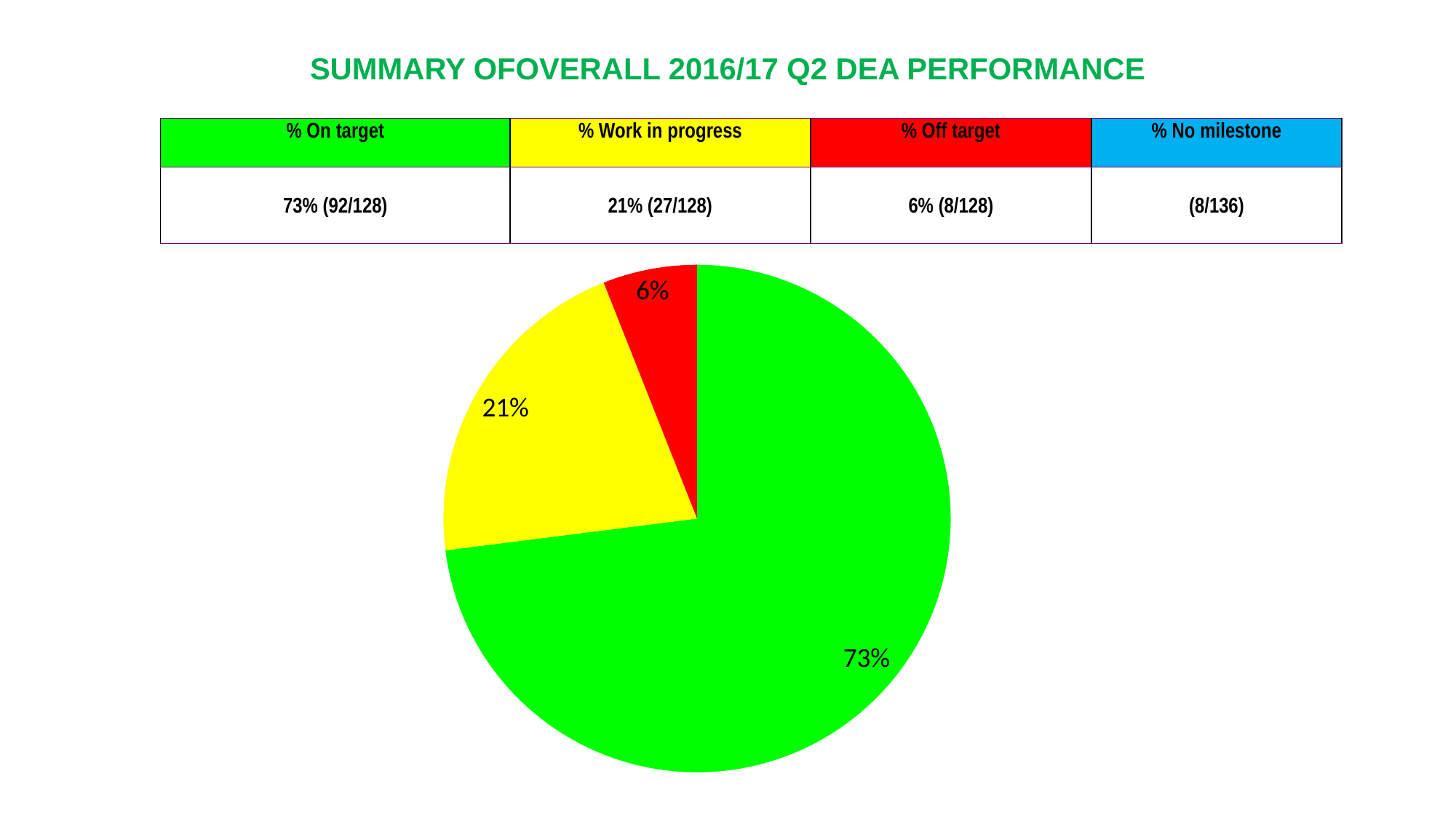
What percentage is shown on the yellow slice of the pie chart? 21% How many slices does the pie chart have? 3 Which is larger in the pie chart, the yellow slice or the red slice? the yellow slice What percentage is shown on the red slice of the pie chart? 6% Which slice of the pie chart is the largest? the green slice (73%) What kind of chart is shown on the slide? pie chart According to the table above the pie chart, which category does the green slice represent? % On target What percentage is shown on the green slice of the pie chart? 73% What is the title of the slide containing the pie chart? SUMMARY OFOVERALL 2016/17 Q2 DEA PERFORMANCE What is the combined share of the yellow and red slices of the pie chart? 27% Which slice of the pie chart is the smallest? the red slice (6%) What is the difference between the green slice and the yellow slice of the pie chart? 52 percentage points